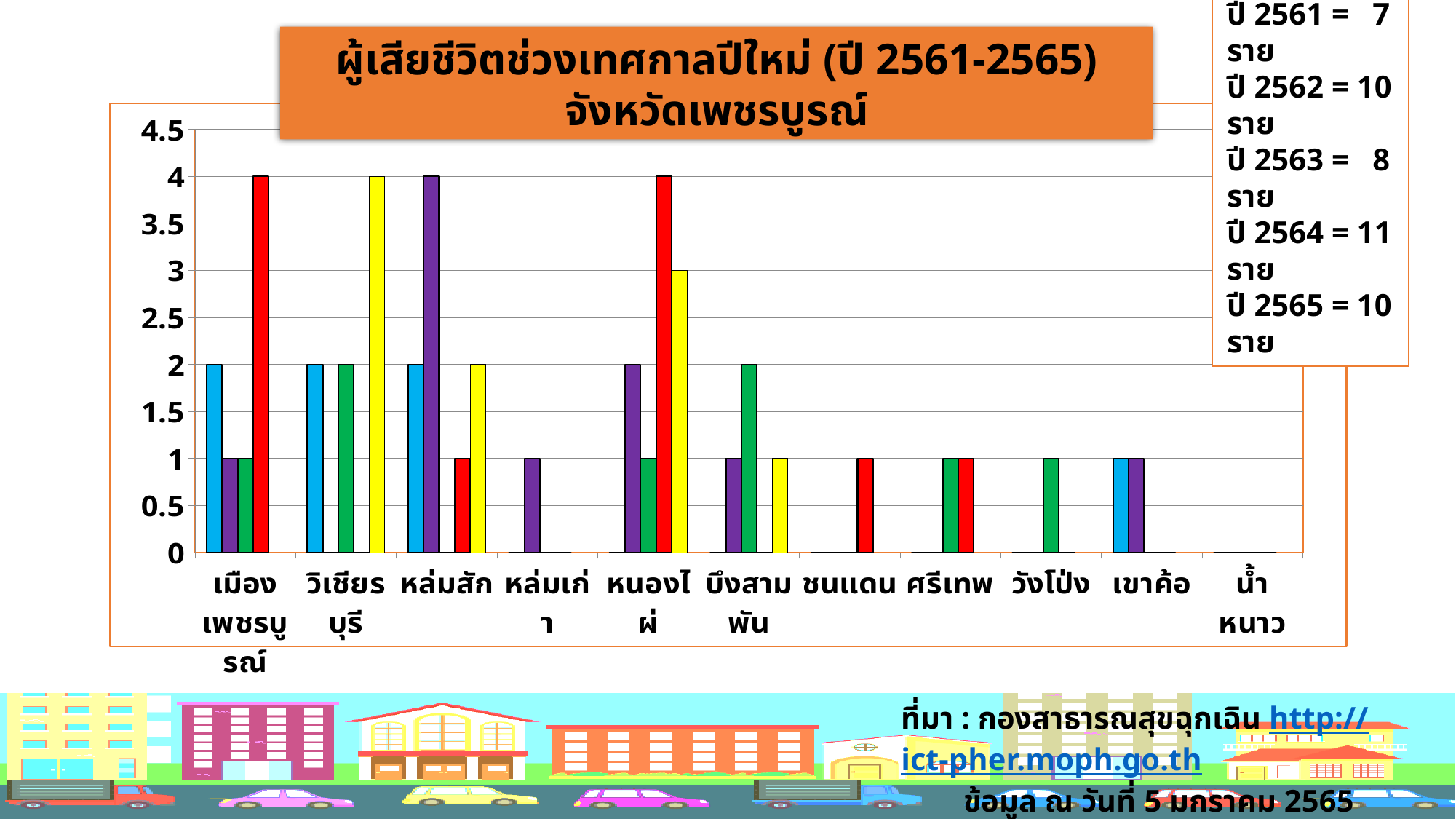
What is the title of the chart? ผู้เสียชีวิตช่วงเทศกาลปีใหม่ (ปี 2561-2565) จังหวัดเพชรบูรณ์ What is the value of the yellow bar for หนองไผ่? 3 What is the value of the red bar for เมืองเพชรบูรณ์? 4 What is the value of the purple bar for หล่มสัก? 4 For เมืองเพชรบูรณ์, which is larger: the blue bar or the purple bar? the blue bar How many bars are plotted for หล่มเก่า? 1 How many categories (districts) are shown on the x axis of the chart? 11 What is the difference between the red bar and the yellow bar for หนองไผ่? 1 Which category has no bars plotted at all? น้ำหนาว What kind of chart is shown on the slide? bar chart Which category has the tallest yellow bar? วิเชียรบุรี Is the value of the red bar for หนองไผ่ greater or less than 3? greater